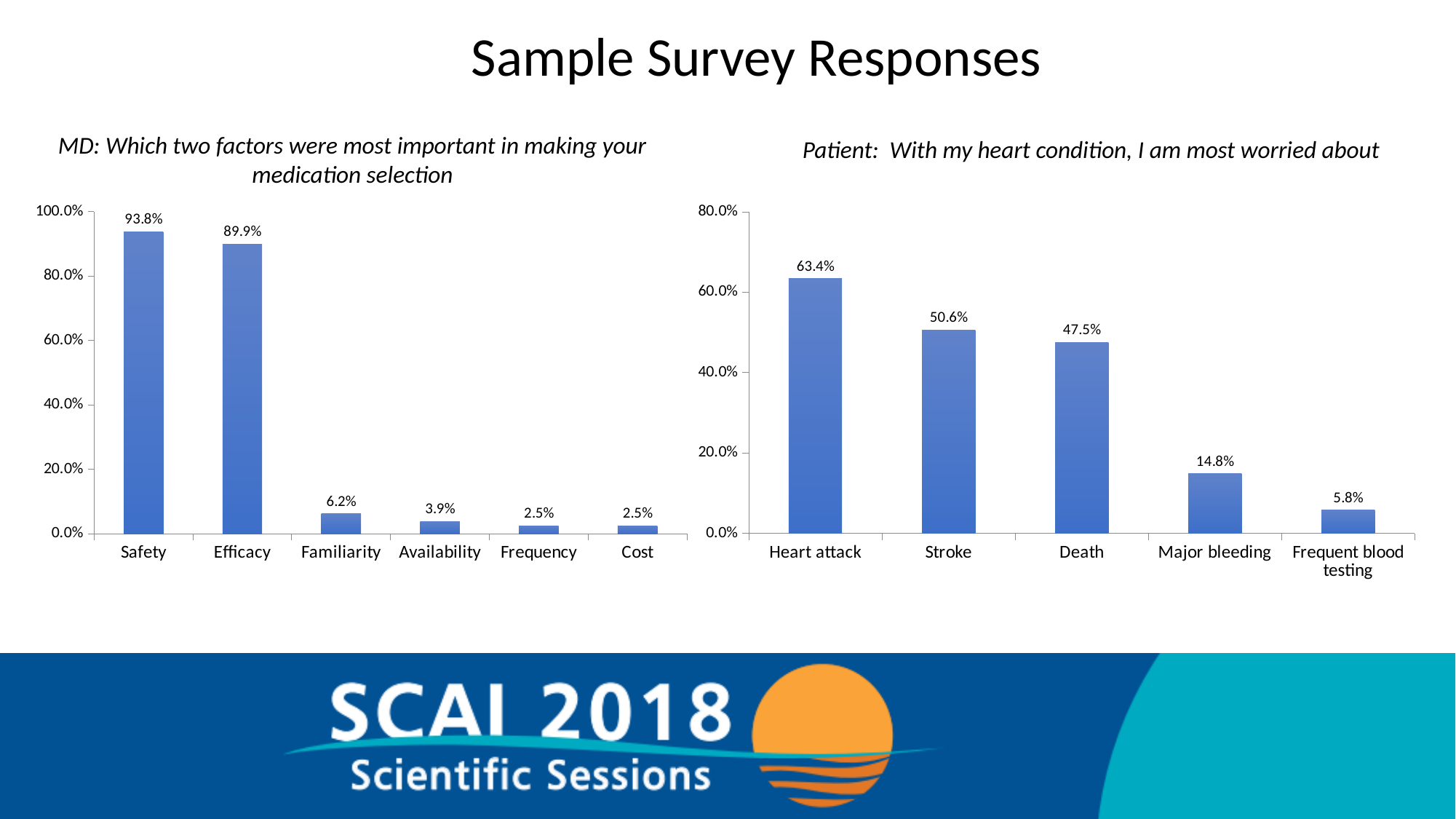
In the left chart (MD: Which two factors were most important in making your medication selection), how many categories are shown? 6 In the left chart (MD: Which two factors were most important in making your medication selection), what is the difference between Safety and Efficacy? 3.9% In the right chart (Patient: With my heart condition, I am most worried about), which category has the lowest value? Frequent blood testing In the right chart (Patient: With my heart condition, I am most worried about), what is the value for Stroke? 50.6% In the left chart (MD: Which two factors were most important in making your medication selection), what is the value for Familiarity? 6.2% In the left chart (MD: Which two factors were most important in making your medication selection), which is larger, Availability or Frequency? Availability In the left chart (MD: Which two factors were most important in making your medication selection), what is the value for Safety? 93.8% In the right chart (Patient: With my heart condition, I am most worried about), what is the difference between Heart attack and Death? 15.9% What kind of chart is the right chart (Patient: With my heart condition, I am most worried about)? bar chart In the left chart (MD: Which two factors were most important in making your medication selection), which category has the highest value? Safety In the right chart (Patient: With my heart condition, I am most worried about), what is the value for Major bleeding? 14.8% In the right chart (Patient: With my heart condition, I am most worried about), do the values rise or fall from left to right? fall